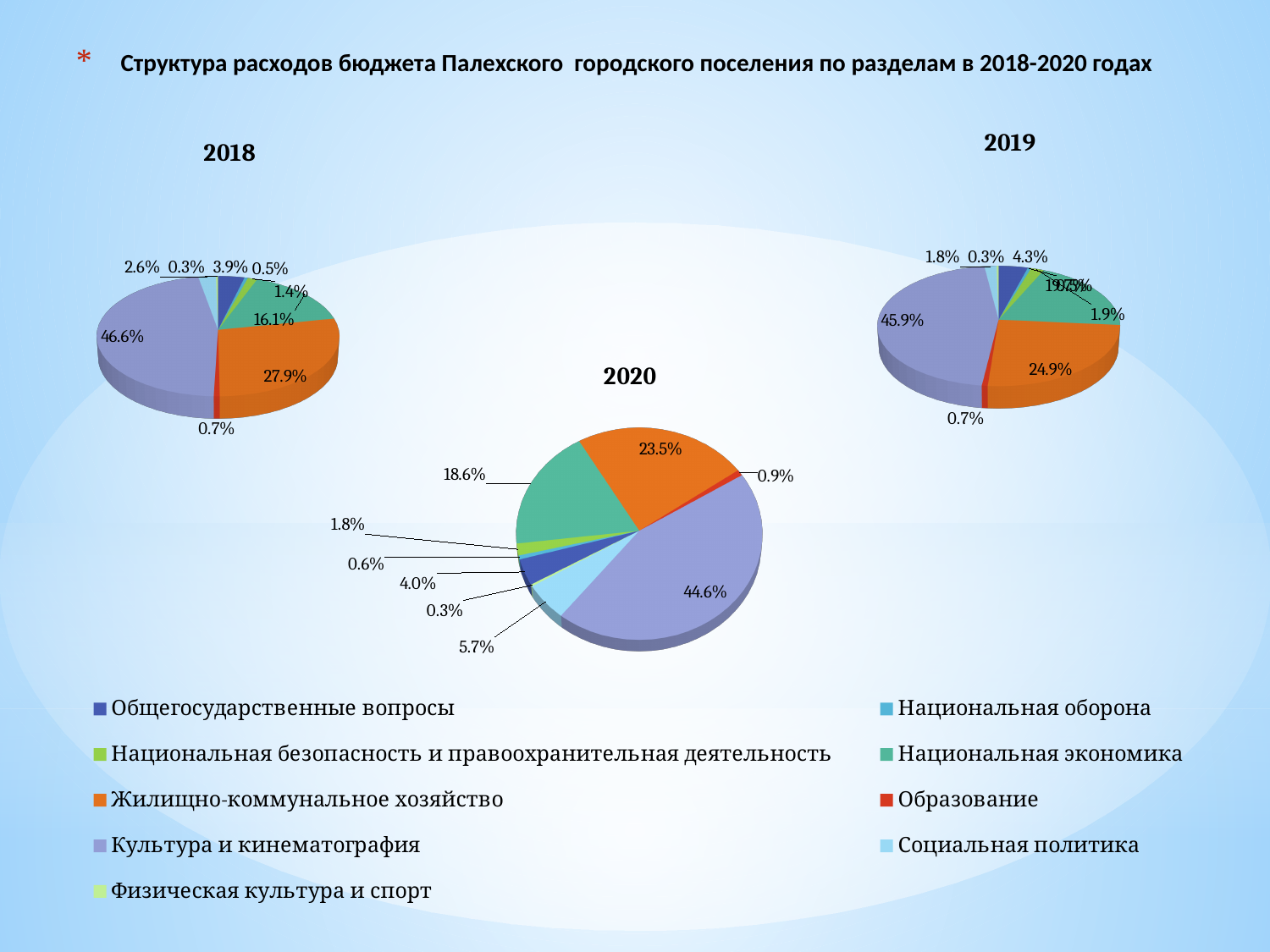
In the 2019 pie chart, what share is shown for Жилищно-коммунальное хозяйство? 24.9% How many categories does the shared legend list? 9 In the 2020 pie chart, which is larger: Жилищно-коммунальное хозяйство or Национальная экономика? Жилищно-коммунальное хозяйство In the 2019 pie chart, what share is shown for Культура и кинематография? 45.9% In the 2018 pie chart, what share is shown for Жилищно-коммунальное хозяйство? 27.9% In the 2018 pie chart, what is the difference in percentage points between Культура и кинематография and Жилищно-коммунальное хозяйство? 18.7 percentage points In the 2020 pie chart, what share is shown for Национальная экономика? 18.6% In the 2020 pie chart, what share is shown for Культура и кинематография? 44.6% What type of chart is used for the 2020 data on this slide? Pie chart In the 2020 pie chart, what share is shown for Образование? 0.9% In the 2018 pie chart, what share is shown for Культура и кинематография? 46.6% In the 2018 pie chart, which category has the largest slice? Культура и кинематография